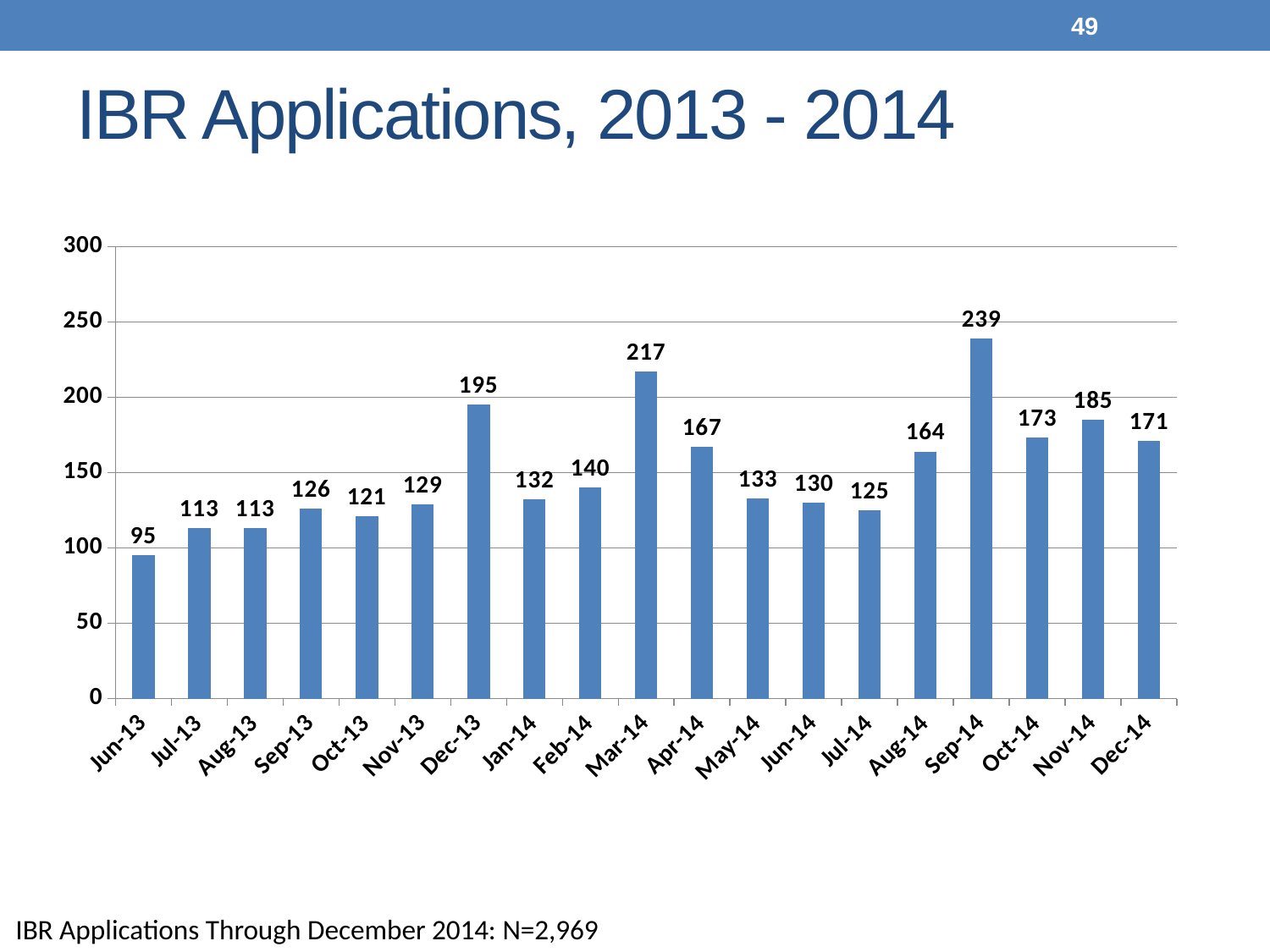
What kind of chart is shown on the slide? Bar chart Do the values rise or fall from Jun-13 to Sep-13? Rise What is the difference between the values for Mar-14 and Feb-14? 77 Is the value for Apr-14 greater or less than 150? greater How many months are shown on the x axis? 19 Which month has the highest value? Sep-14 What is the title of the slide? IBR Applications, 2013 - 2014 Which is larger, the value for Nov-14 or the value for Oct-14? Nov-14 Which month has the lowest value? Jun-13 What is the value for Dec-13? 195 What is the value for Sep-14? 239 What is the value for Jul-14? 125